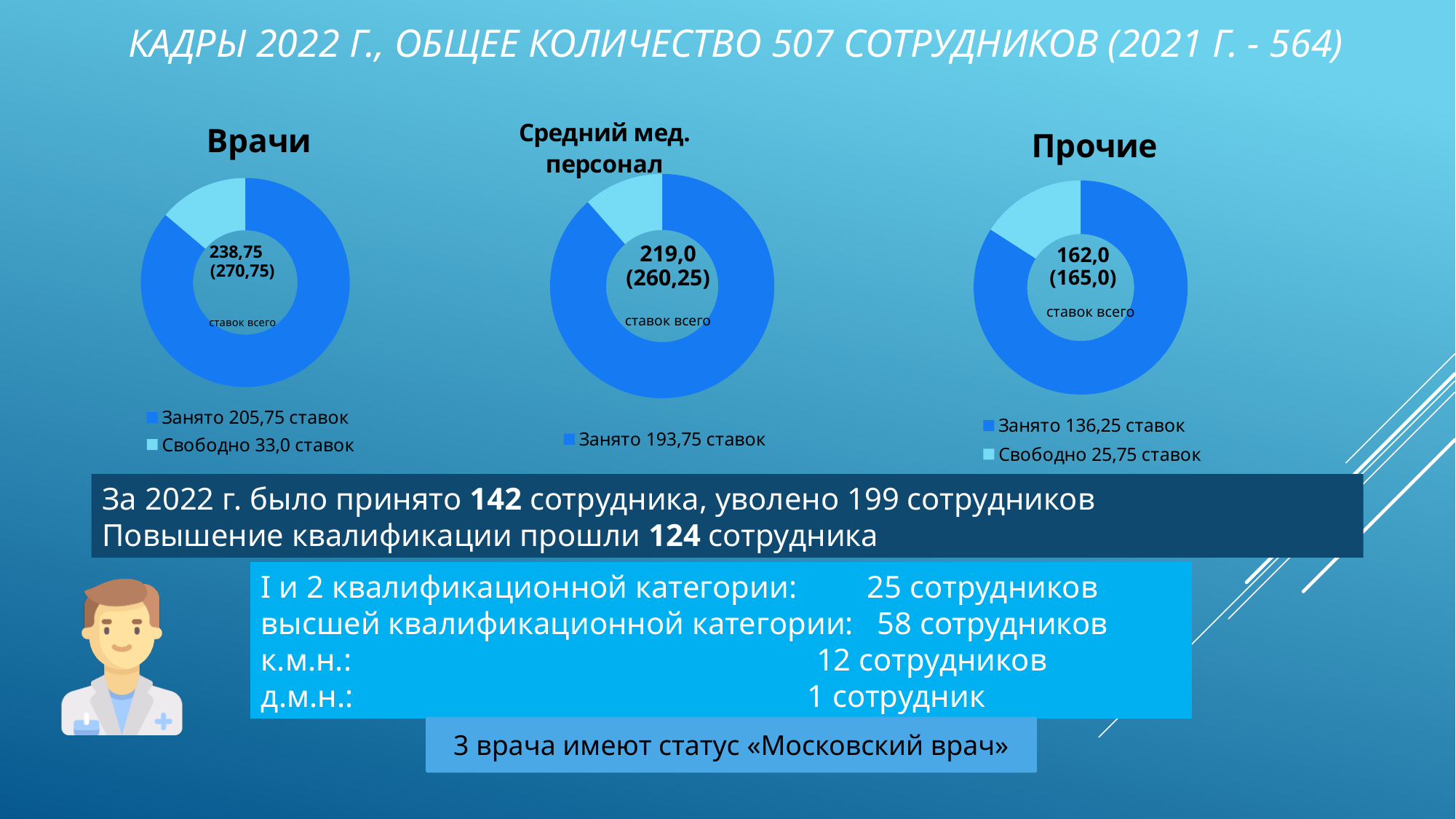
Which chart has the largest number of occupied (Занято) rates? Врачи What kind of chart is used for the "Врачи" chart? Doughnut (pie) chart In the "Средний мед. персонал" chart, how many rates are occupied (Занято) according to the legend? 193,75 ставок How many charts are shown on the slide? 3 In the "Врачи" chart, which slice is larger: Занято or Свободно? Занято What total number of rates (ставок всего) is printed in the centre of the "Средний мед. персонал" chart? 219,0 (260,25) In the "Врачи" chart, how many rates are occupied (Занято) according to the legend? 205,75 ставок In the "Врачи" chart, how many rates are free (Свободно) according to the legend? 33,0 ставок In the "Врачи" chart, what is the difference between the occupied (Занято) and free (Свободно) rates? 172,75 ставок In the "Прочие" chart, how many rates are free (Свободно) according to the legend? 25,75 ставок How many legend entries does the "Средний мед. персонал" chart list? 1 In the "Прочие" chart, how many rates are occupied (Занято) according to the legend? 136,25 ставок